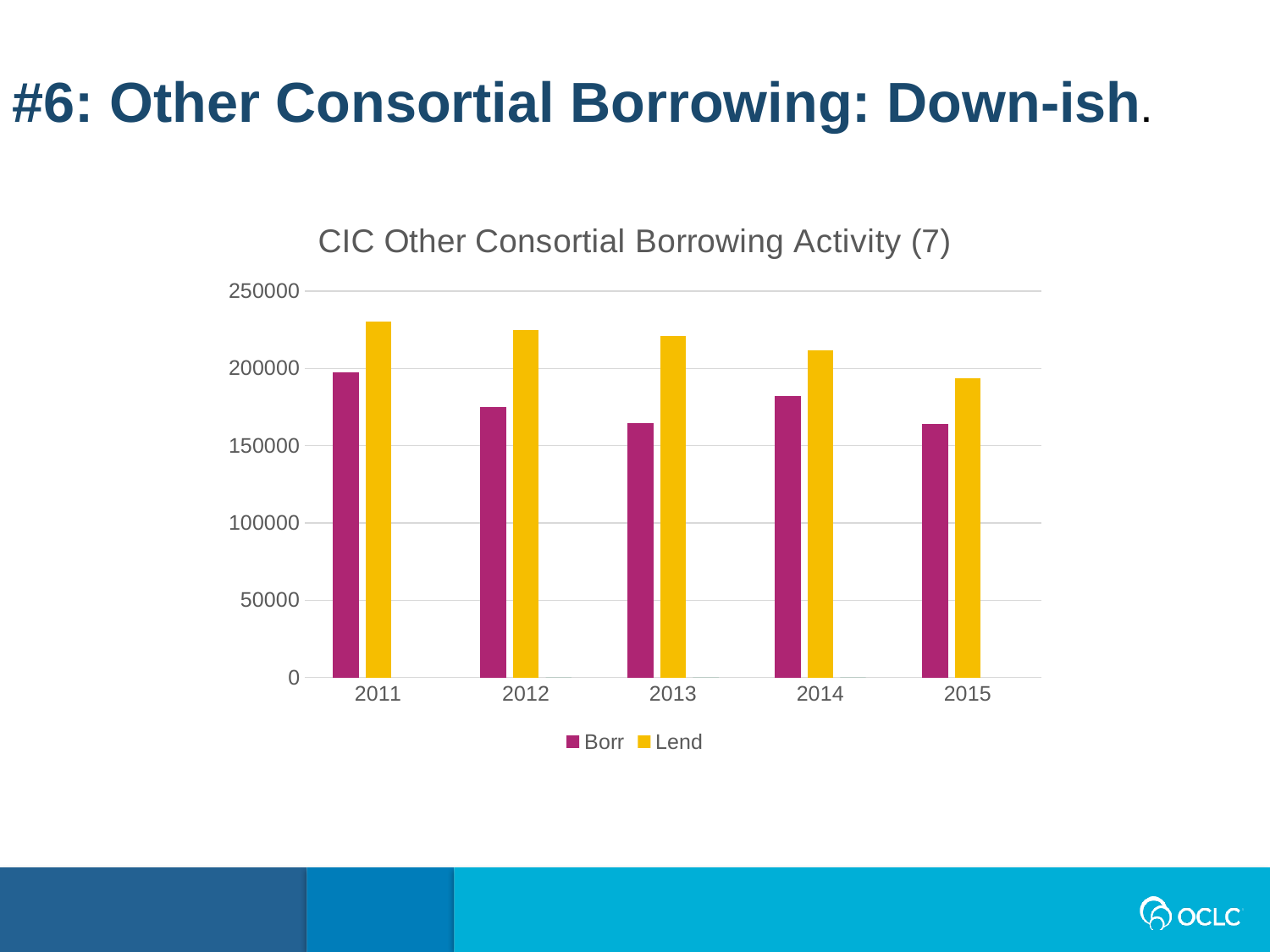
Which year has the lowest Lend value? 2015 In 2013, which is larger, Borr or Lend? Lend Is the Lend value for 2014 greater or less than 200000? greater Which is larger, the Borr value for 2014 or the Borr value for 2013? 2014 Which year has the highest Borr value? 2011 Do the Lend values rise or fall from 2011 to 2015? fall What kind of chart is shown on the slide? bar chart What is the title of the chart? CIC Other Consortial Borrowing Activity (7) How many series does the legend list? 2 Is the Borr value for 2013 greater or less than 150000? greater How many years are shown on the x axis? 5 Is the Lend value for 2011 greater or less than 200000? greater